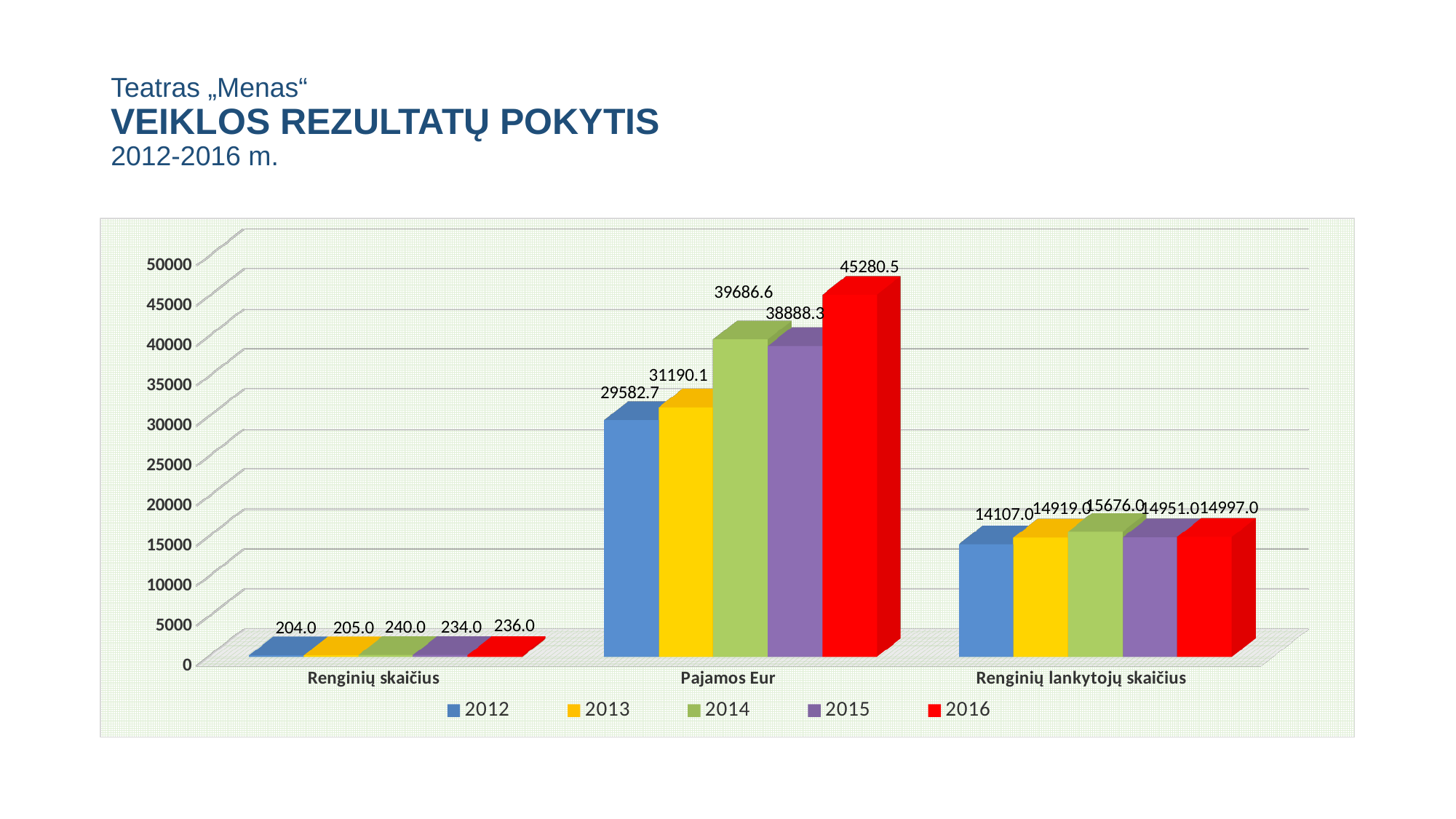
What is the value for 2012 in the Renginių skaičius category? 204.0 Which year has the lowest value in the Renginių lankytojų skaičius category? 2012 What is the value for 2014 in the Renginių lankytojų skaičius category? 15676.0 Is the value for 2013 in the Pajamos Eur category greater or less than 30000? greater Which colour represents the 2016 series in the legend? red Which is larger in the Renginių skaičius category, the value for 2014 or the value for 2015? 2014 How many series does the legend list? 5 What is the difference between the 2016 and 2012 values in the Pajamos Eur category? 15697.8 What is the value for 2016 in the Pajamos Eur category? 45280.5 What kind of chart is shown on the slide? bar chart Which year has the highest value in the Pajamos Eur category? 2016 How many categories are shown on the x axis? 3